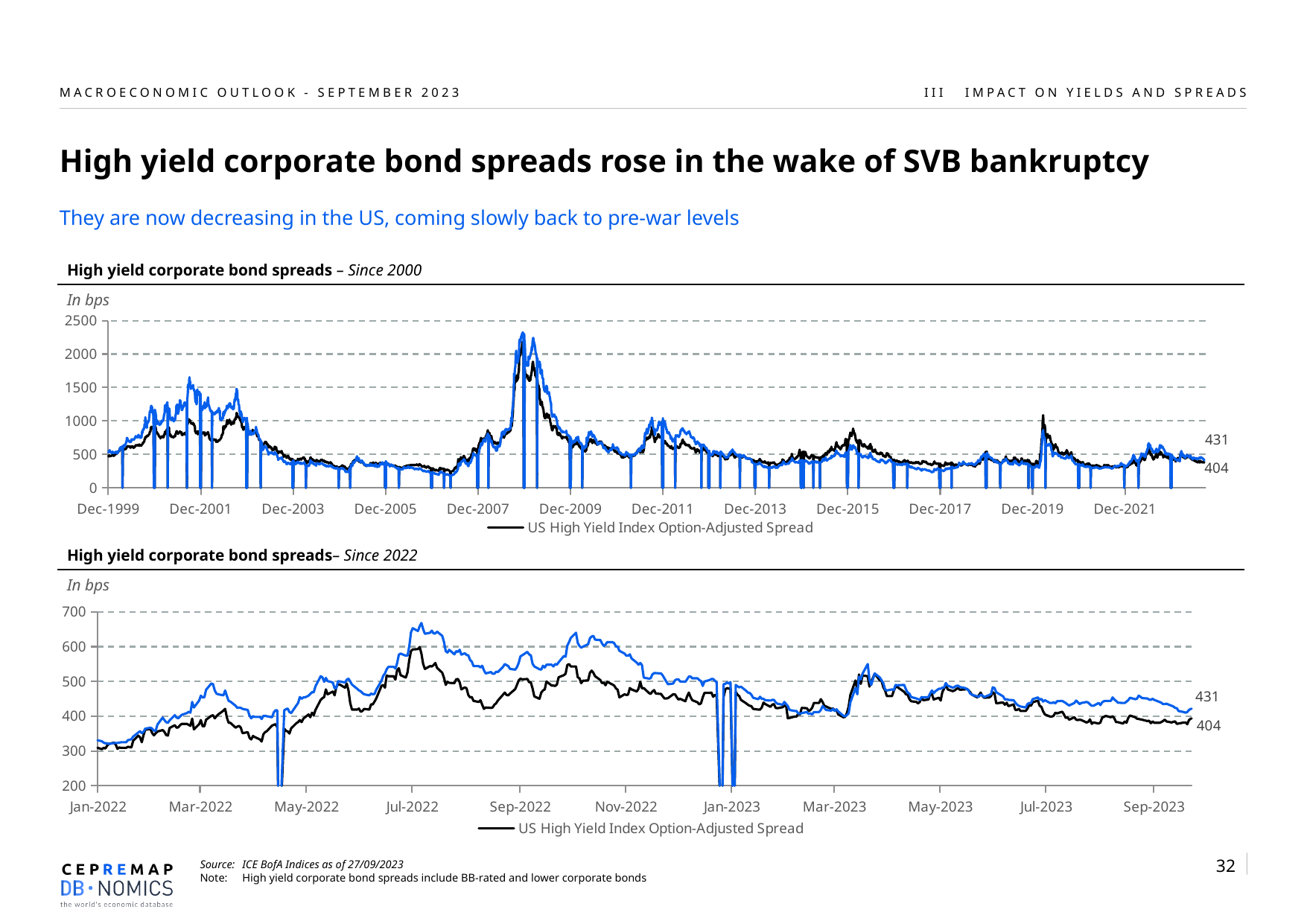
In the 'High yield corporate bond spreads – Since 2022' chart, what is the latest value labelled for the US High Yield Index Option-Adjusted Spread (black line)? 404 In the 'High yield corporate bond spreads – Since 2022' chart, is the value of the US High Yield Index Option-Adjusted Spread at Jan-2022 greater or less than 400? less In the 'High yield corporate bond spreads – Since 2000' chart, between which two x-axis labels does the highest spike in spreads occur? Dec-2007 and Dec-2009 In the 'High yield corporate bond spreads – Since 2022' chart, does the US High Yield Index Option-Adjusted Spread rise or fall from Jan-2022 to Jul-2022? rise How many series does the legend of the 'High yield corporate bond spreads – Since 2022' chart list? 1 How many x-axis date labels are shown on the 'High yield corporate bond spreads – Since 2022' chart? 11 In the 'High yield corporate bond spreads – Since 2022' chart, at the end of the series is the US High Yield Index Option-Adjusted Spread (black line) above or below the blue line? below In the 'High yield corporate bond spreads – Since 2022' chart, what is the difference between the two end-of-series labels, 431 and 404? 27 What kind of chart is the 'High yield corporate bond spreads – Since 2000' chart? line chart In the 'High yield corporate bond spreads – Since 2022' chart, what is the latest value labelled at the end of the blue line? 431 In what unit are the values on both charts expressed, according to the axis label? In bps In the 'High yield corporate bond spreads – Since 2000' chart, is the peak of the US High Yield Index Option-Adjusted Spread between Dec-2007 and Dec-2009 greater or less than 1500? greater